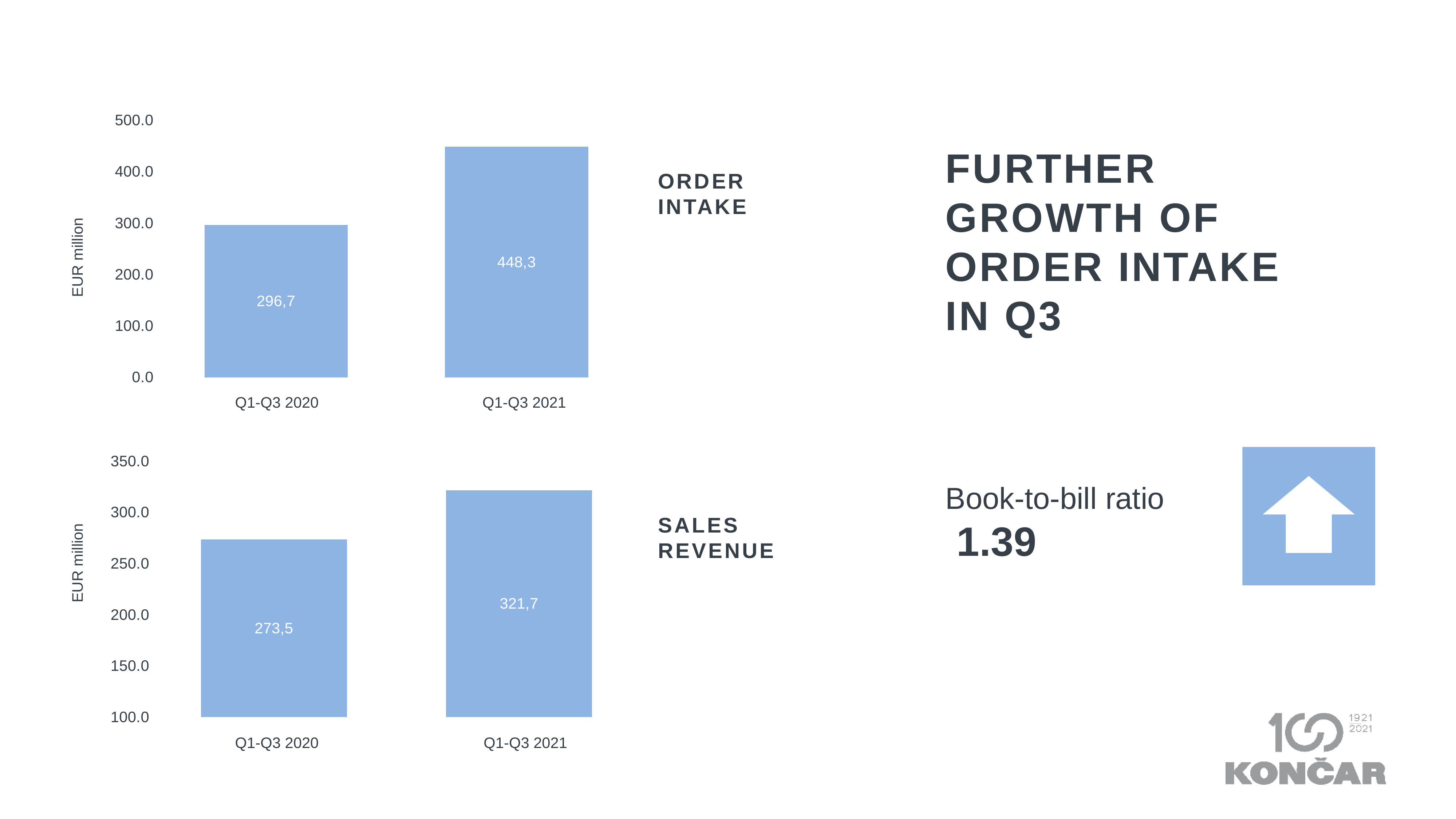
In the Sales Revenue chart, what is the value for Q1-Q3 2021? 321,7 What unit is shown on the vertical axis of the Sales Revenue chart? EUR million In the Order Intake chart, which period has the higher value? Q1-Q3 2021 What type of chart is the Order Intake chart? bar chart In the Sales Revenue chart, what is the difference between the Q1-Q3 2021 and Q1-Q3 2020 values? 48,2 In the Order Intake chart, what is the value for Q1-Q3 2020? 296,7 In the Sales Revenue chart, what is the value for Q1-Q3 2020? 273,5 In the Order Intake chart, what is the difference between the Q1-Q3 2021 and Q1-Q3 2020 values? 151,6 In the Sales Revenue chart, which period has the lower value? Q1-Q3 2020 How many bars are shown in the Sales Revenue chart? 2 In the Order Intake chart, what is the value for Q1-Q3 2021? 448,3 In the Order Intake chart, is the value for Q1-Q3 2021 greater or less than 400.0? greater